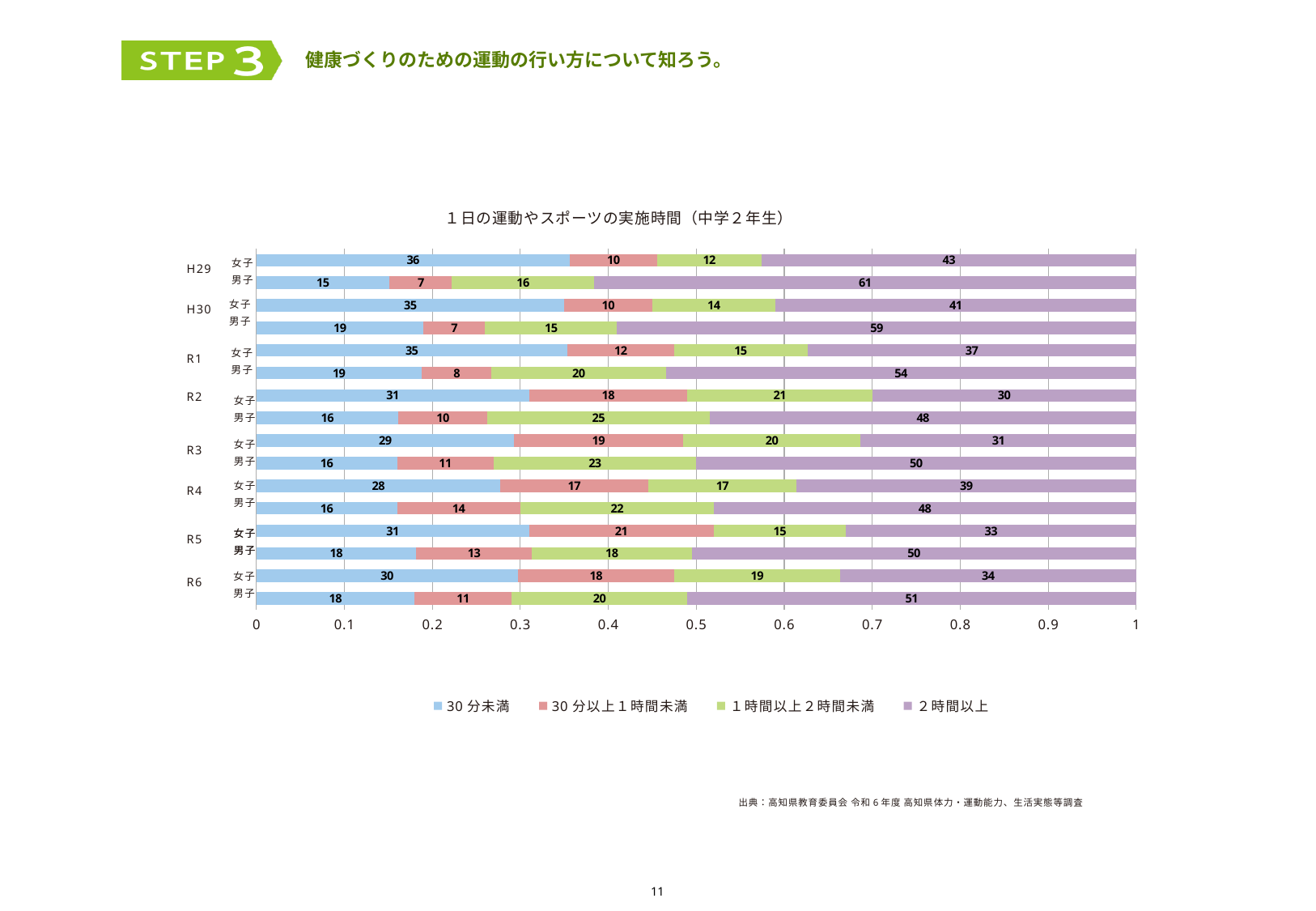
How many series does the legend list? 4 What is the value for 30 分以上 1 時間未満 for R5 女子? 21 Which bar has the lowest value for 30 分未満? H29 男子 What is the value for 2 時間以上 for R6 男子? 51 What is the value for 1 時間以上 2 時間未満 for R2 男子? 25 What is the title of the chart? １日の運動やスポーツの実施時間（中学２年生） How many bars are plotted in the chart? 16 Which bar has the highest value for 2 時間以上? H29 男子 What is the difference between the 2 時間以上 values for H29 男子 and H29 女子? 18 Which is larger: the 30 分未満 value for R4 女子 or for R4 男子? R4 女子 What is the value for 30 分未満 for H29 女子? 36 What kind of chart is shown on the slide? Stacked bar chart